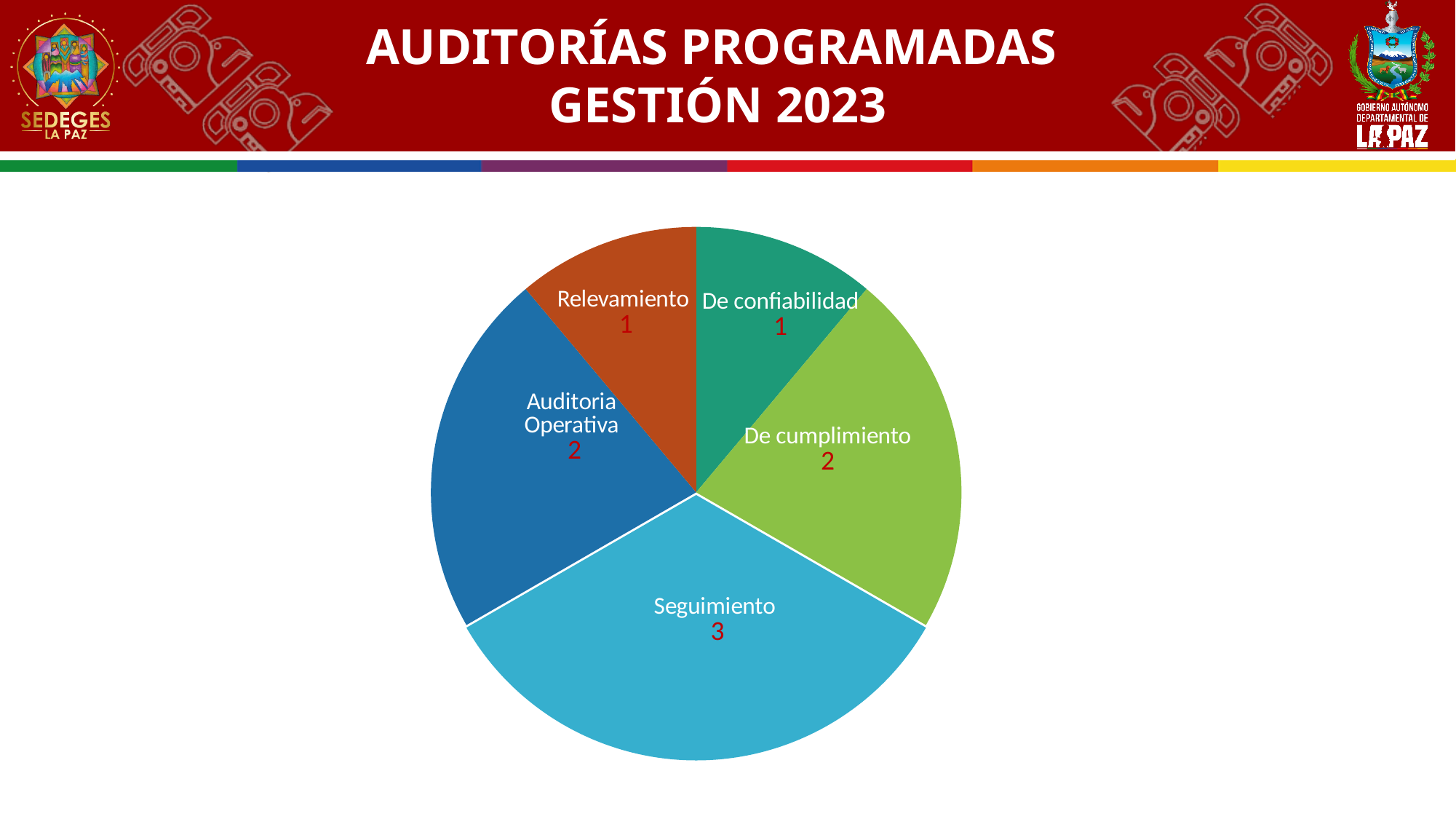
What is the title of the slide containing the pie chart? AUDITORÍAS PROGRAMADAS GESTIÓN 2023 What is the total of all the values shown in the pie chart? 9 What type of chart is shown on the slide? pie chart What is the value for Auditoria Operativa? 2 What is the value for Seguimiento? 3 How many slices does the pie chart have? 5 What is the difference between the values for Seguimiento and De confiabilidad? 2 What is the value for De cumplimiento? 2 Which is larger, the value for Seguimiento or the value for Relevamiento? Seguimiento What share of the total does the Seguimiento slice represent? one third (3 of 9) Which category has the largest slice of the pie? Seguimiento What is the value for Relevamiento? 1